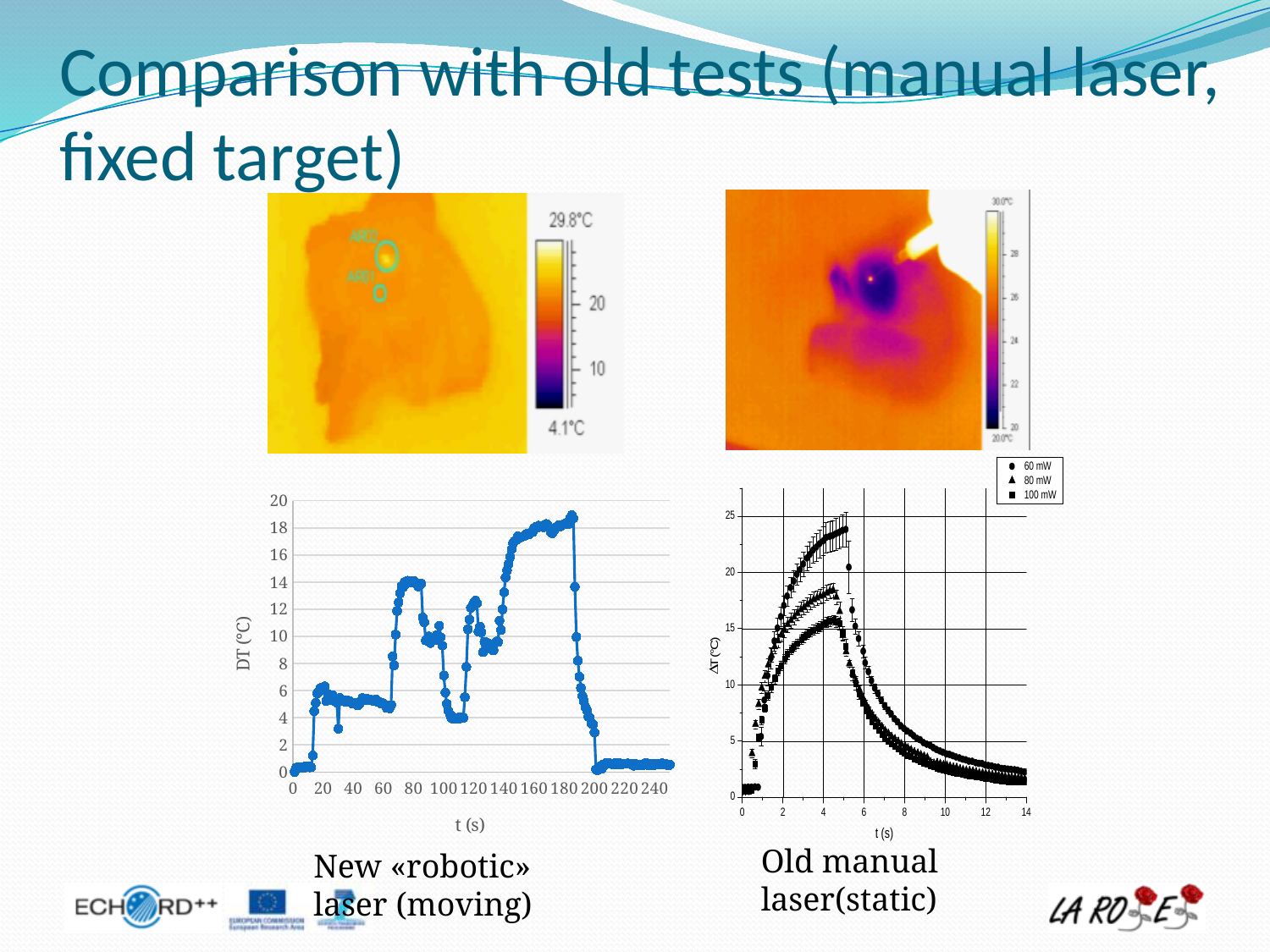
How many series does the legend of the right chart ('Old manual laser (static)') list? 3 In the left chart ('New «robotic» laser (moving)'), is the value of DT at t = 80 s greater or less than 12? greater In the left chart ('New «robotic» laser (moving)'), is the value of DT at t = 220 s greater or less than 2? less What kind of chart is the right chart labelled 'Old manual laser (static)'? scatter plot In the right chart ('Old manual laser (static)'), is the value of the 100 mW series at t = 12 s greater or less than 5? less What is the label of the x axis on the left chart ('New «robotic» laser (moving)')? t (s) In the right chart ('Old manual laser (static)'), which series reaches the lowest peak ΔT? 60 mW In the right chart ('Old manual laser (static)'), do the values of the 80 mW series rise or fall between t = 6 s and t = 14 s? fall In the right chart ('Old manual laser (static)'), which series reaches the highest ΔT? 100 mW What kind of chart is the left chart labelled 'New «robotic» laser (moving)'? line chart